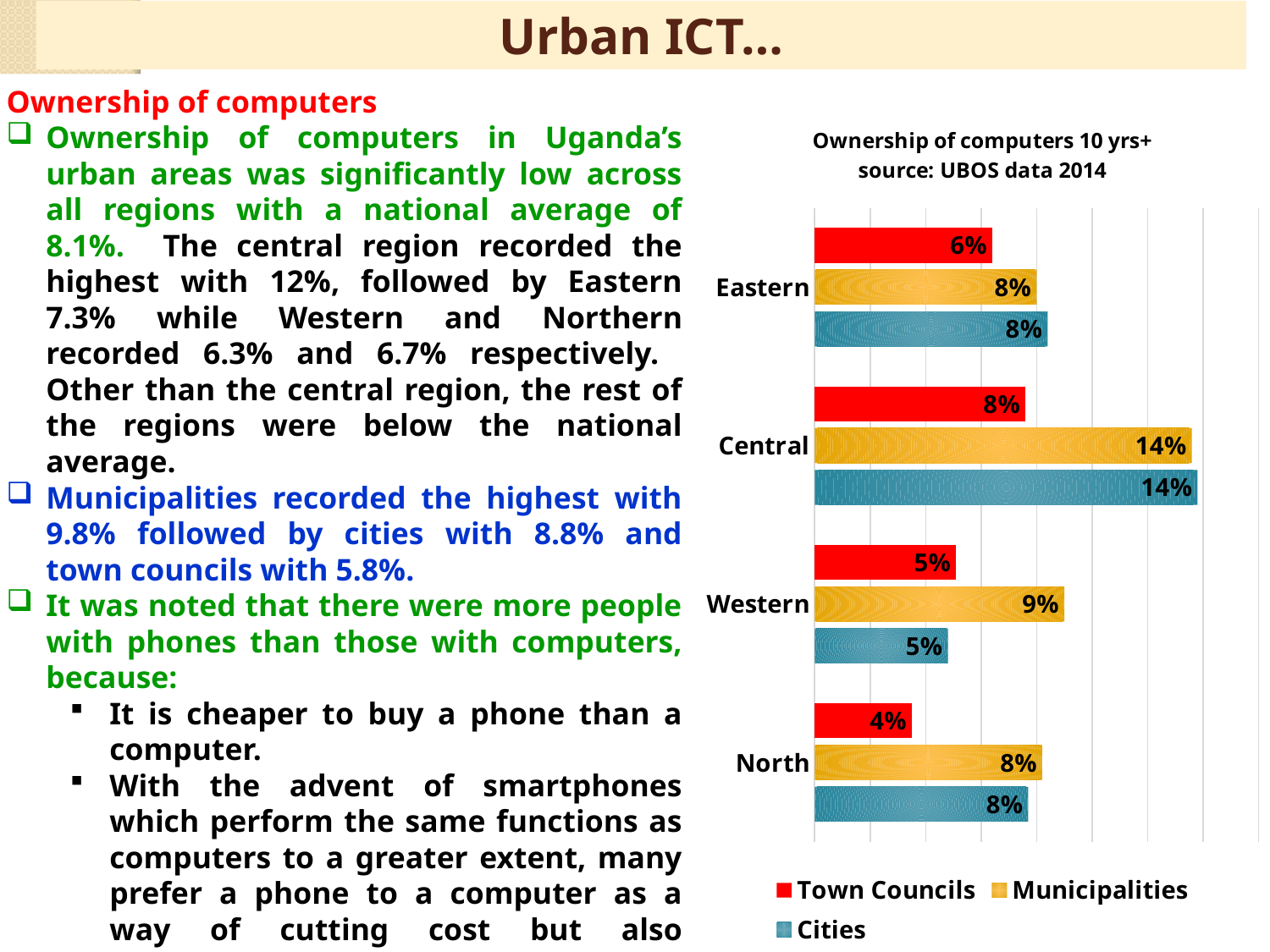
How many series does the legend list? 3 What is the difference between the Municipalities value for Central and the Municipalities value for Western? 5% What is the value for Town Councils in the North region? 4% Which region has the highest value for Municipalities? Central Which series is shown in red in the chart legend? Town Councils Which region has the lowest value for Town Councils? North How many regions are shown on the chart? 4 What is the value for Town Councils in the Eastern region? 6% What is the value for Cities in the Western region? 5% What is the value for Municipalities in the Central region? 14% In the Western region, which is larger: the value for Municipalities or the value for Cities? Municipalities What kind of chart is shown on the slide? Bar chart